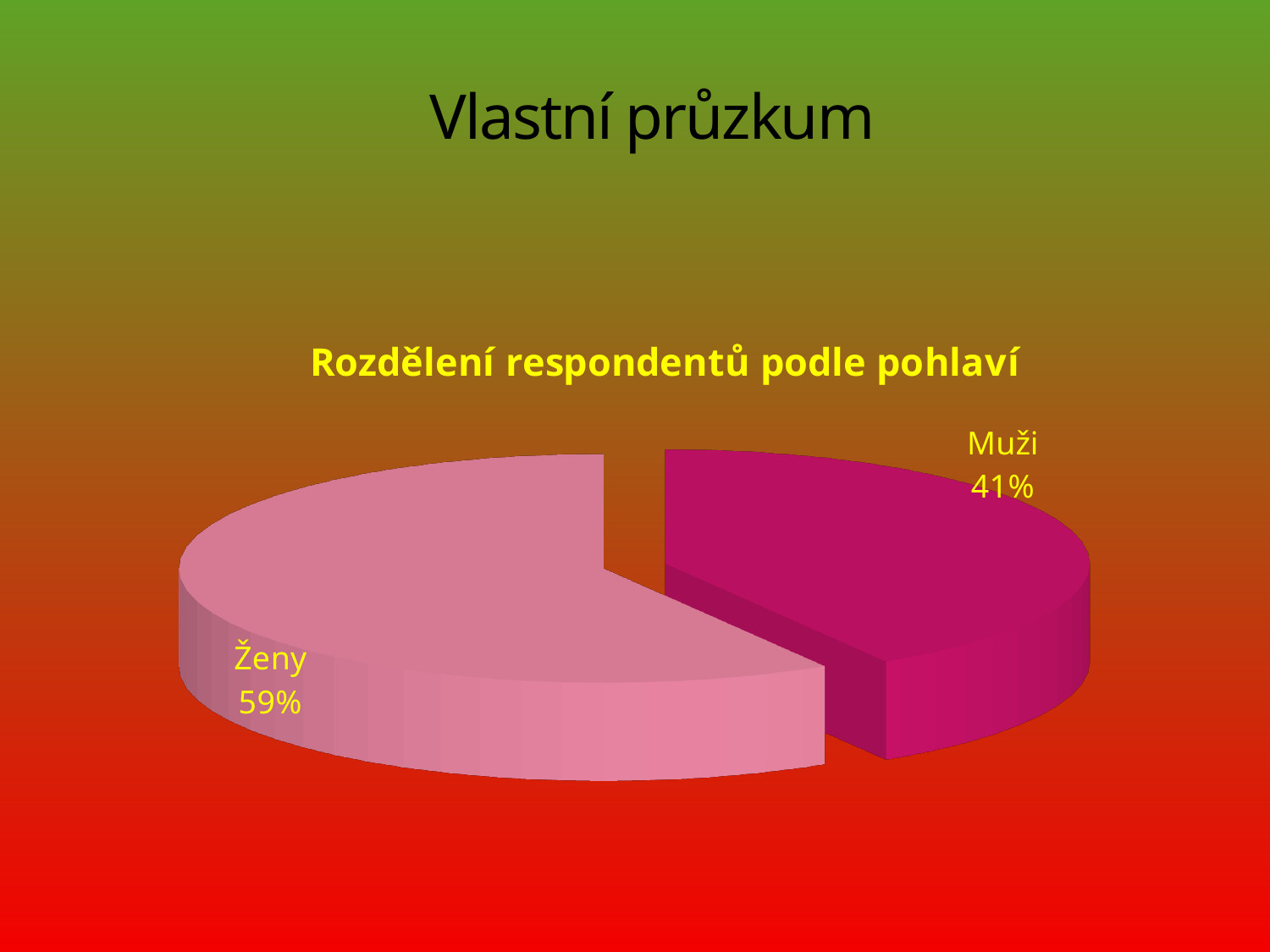
Which category has the smallest share of the pie? Muži Is the share for Ženy greater or less than 50%? greater What is the title of the chart? Rozdělení respondentů podle pohlaví What is the difference in percentage points between the Ženy and Muži shares? 18 Which category is shown in the darker magenta slice? Muži Which category has the largest share of the pie? Ženy What kind of chart is shown on the slide? Pie chart Is the share for Muži greater or less than 50%? less How many categories does the pie chart show? 2 What share of respondents are Muži? 41% Which is larger, the share for Ženy or the share for Muži? Ženy What share of respondents are Ženy? 59%